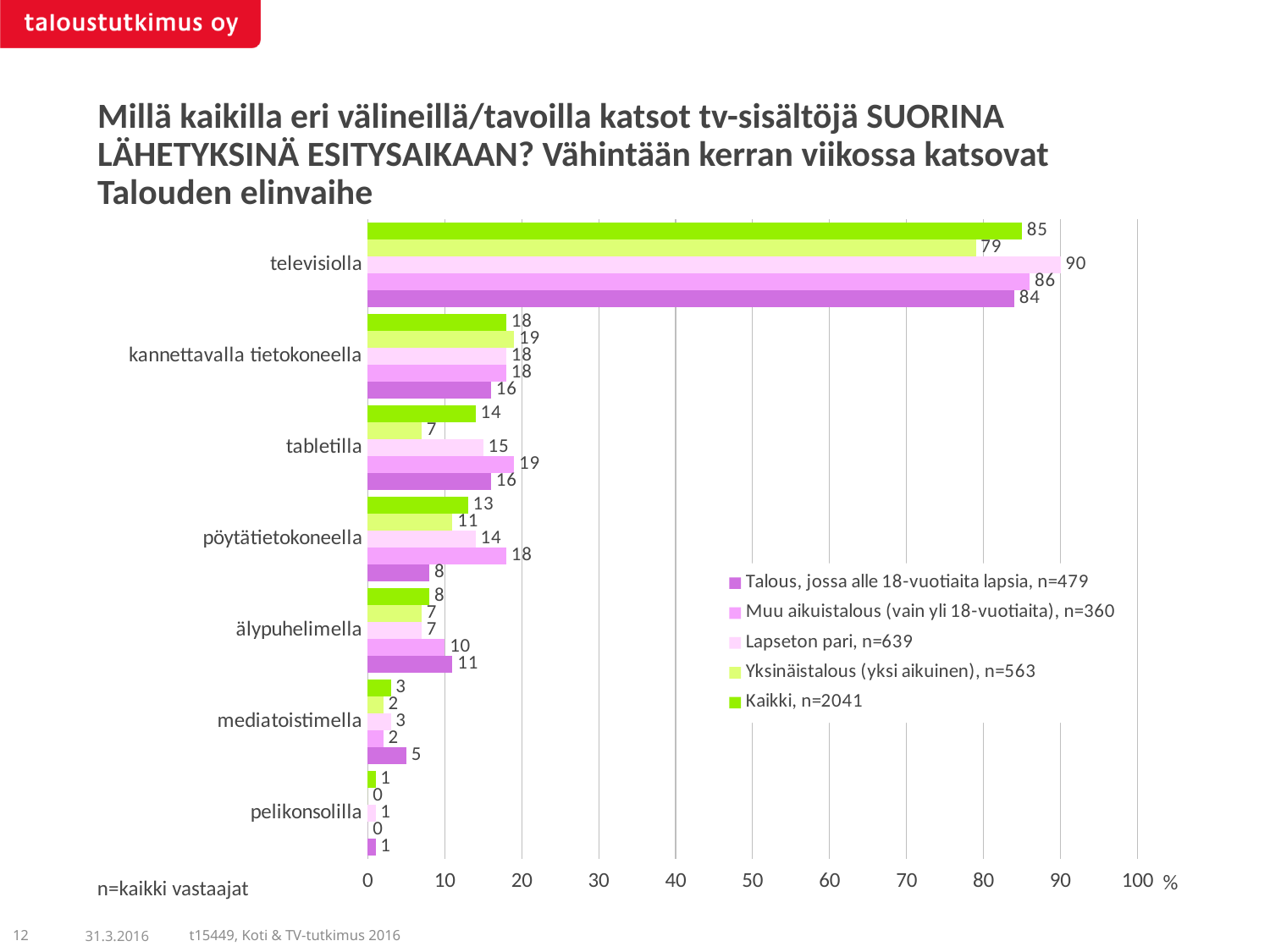
For 'älypuhelimella', which series has the larger value: 'Talous, jossa alle 18-vuotiaita lapsia, n=479' or 'Kaikki, n=2041'? Talous, jossa alle 18-vuotiaita lapsia, n=479 What is the value for 'tabletilla' in the 'Yksinäistalous (yksi aikuinen), n=563' series? 7 What kind of chart is shown on the slide? bar chart How many series does the legend list? 5 What is the difference between the 'Lapseton pari, n=639' and 'Yksinäistalous (yksi aikuinen), n=563' values for 'televisiolla'? 11 What is the value for 'televisiolla' in the 'Lapseton pari, n=639' series? 90 Which category has the highest value in the 'Kaikki, n=2041' series? televisiolla How many categories (viewing devices) are shown on the chart? 7 Which category has the lowest value in the 'Muu aikuistalous (vain yli 18-vuotiaita), n=360' series? pelikonsolilla What is the sample size (n) given in the legend for the 'Kaikki' series? n=2041 What is the value for 'pöytätietokoneella' in the 'Talous, jossa alle 18-vuotiaita lapsia, n=479' series? 8 What is the value for 'televisiolla' in the 'Kaikki, n=2041' series? 85